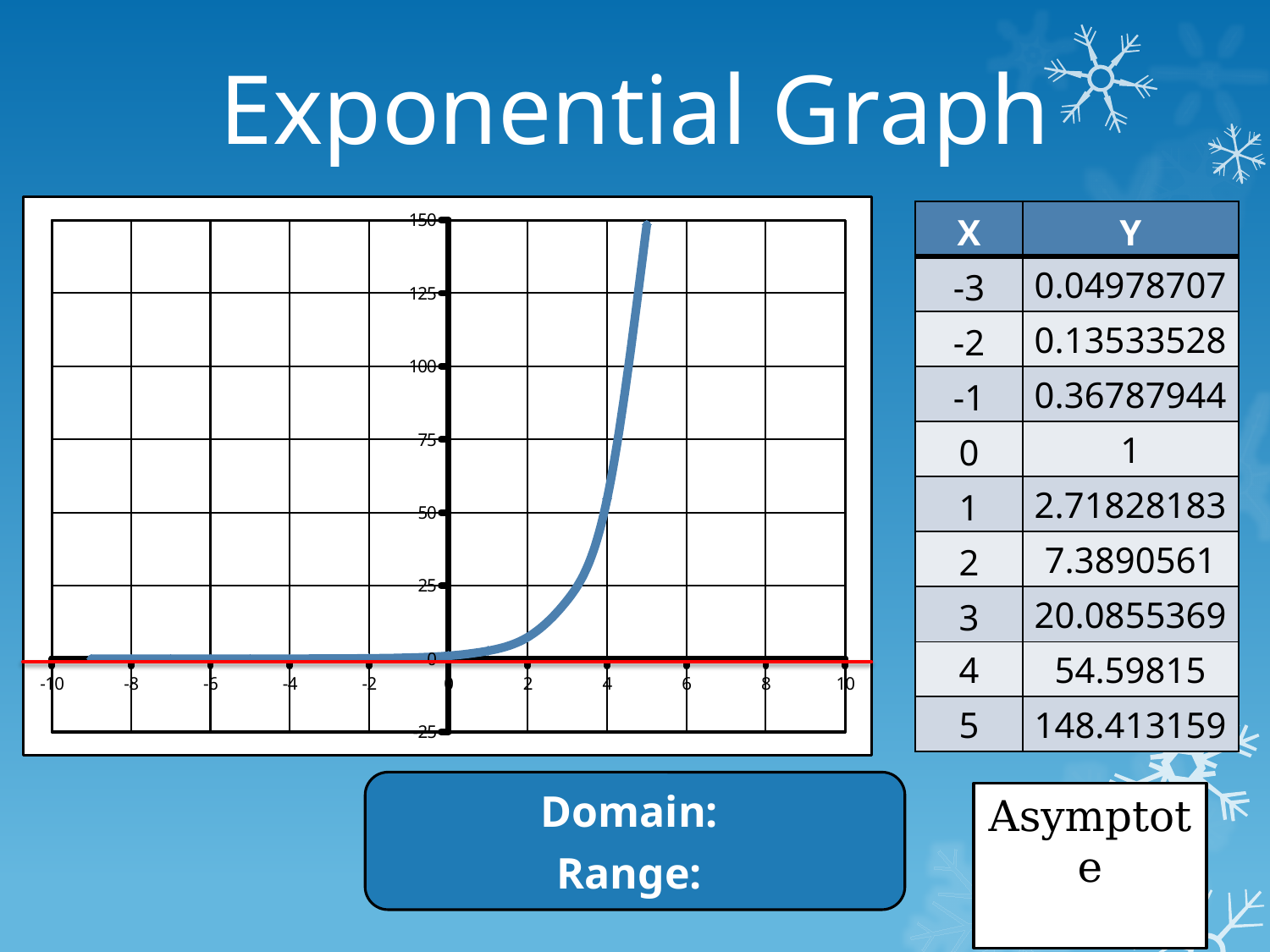
What kind of chart is shown on the slide? line chart According to the table, what is the Y value when X is 5? 148.413159 Is the plotted value at x = 5 greater or less than 100? greater Which has the larger Y value in the table, X = 4 or X = 3? X = 4 Is the plotted value at x = 3 greater or less than 25? less Which X value in the table has the lowest Y value? -3 Which X value in the table has the highest Y value? 5 According to the table, what is the Y value when X is 0? 1 Do the plotted values rise or fall as x increases from left to right? rise According to the table, what is the Y value when X is 3? 20.0855369 What is the title of the slide containing the chart? Exponential Graph How many X values are listed in the table? 9